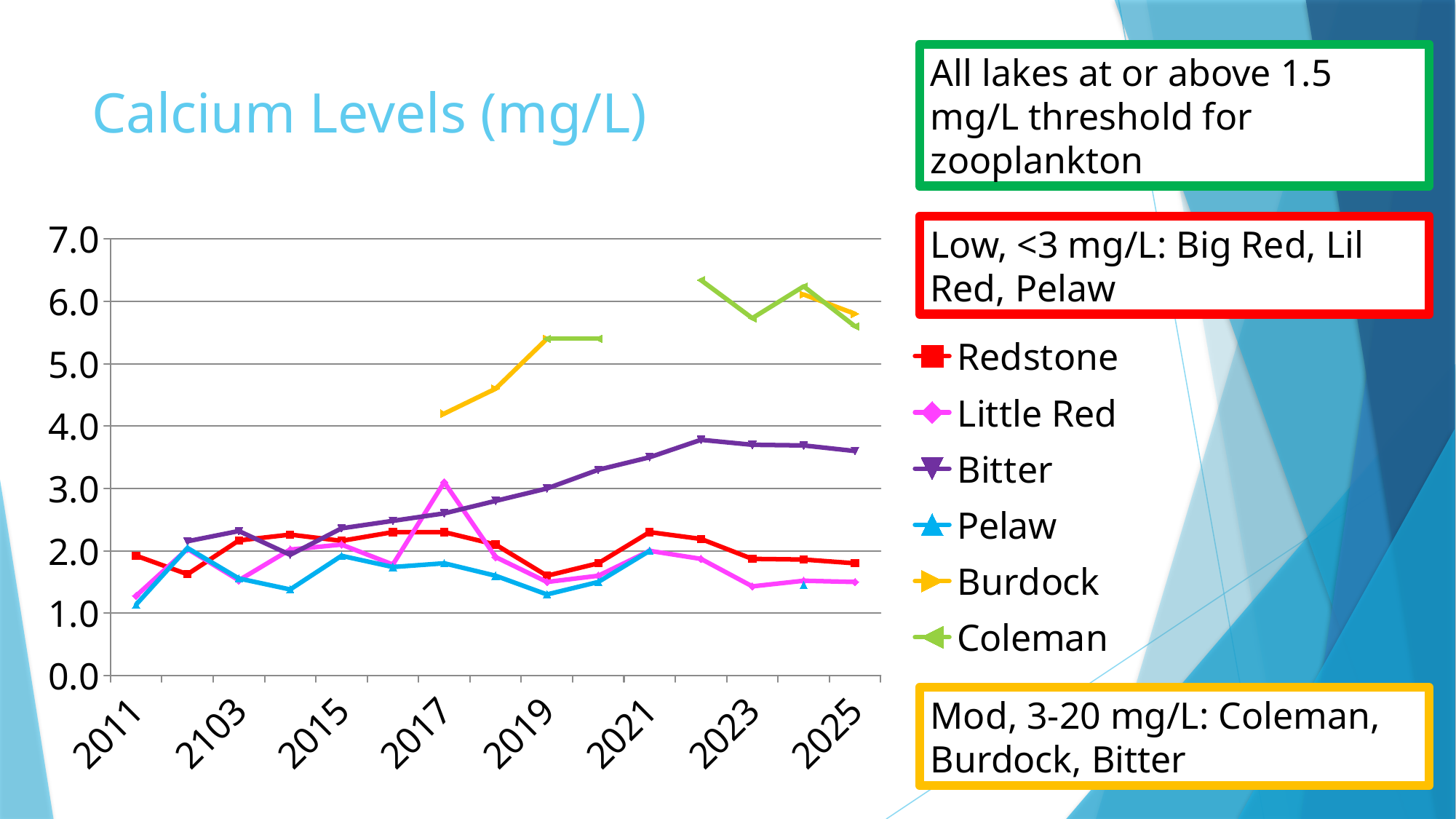
Is the value for Redstone in 2011 greater or less than 3.0? less How many series does the legend list? 6 What colour is the Bitter series line? purple Which series has the highest value in 2021? Bitter What kind of chart is shown on the slide? line chart How many year labels are shown on the x axis? 8 Is the value for Coleman in 2023 greater or less than 5.0? greater Is the value for Pelaw in 2019 greater or less than 2.0? less What is the title of the chart? Calcium Levels (mg/L) Does the Bitter series rise or fall from 2015 to 2023? rise